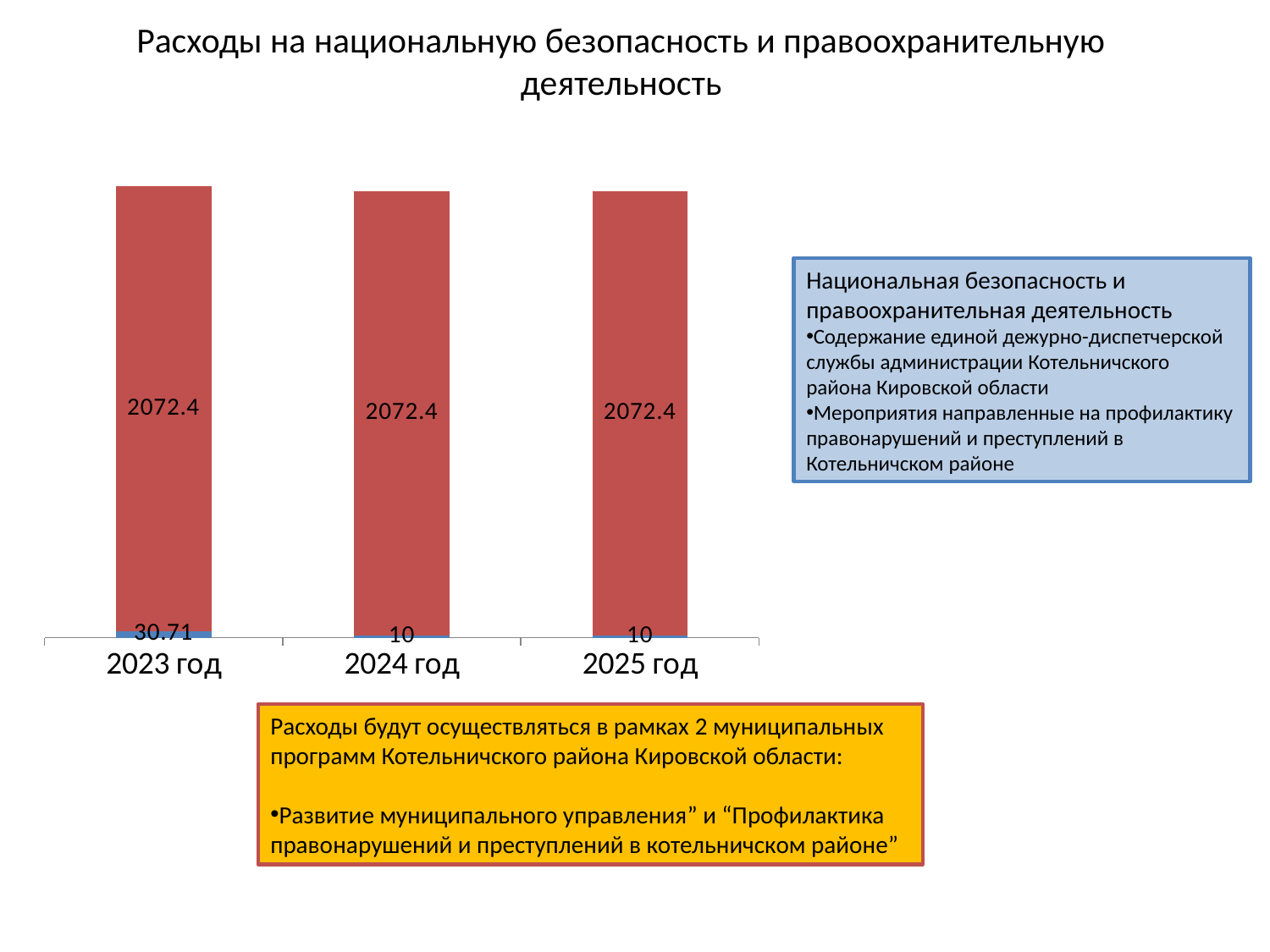
What kind of chart is shown on the slide? bar chart What is the value of the blue segment for 2023 год? 30.71 Which year has the highest value for the blue segment? 2023 год What is the title of the chart on the slide? Расходы на национальную безопасность и правоохранительную деятельность How many categories (years) are shown on the x axis of the chart? 3 What is the value of the red segment for 2023 год? 2072.4 What is the total of the stacked bar for 2024 год? 2082.4 What is the value of the red segment for 2025 год? 2072.4 What is the difference between the blue segment values for 2023 год and 2024 год? 20.71 Is the blue segment value for 2023 год larger or smaller than the blue segment value for 2025 год? larger What is the value of the blue segment for 2024 год? 10 What is the total of the stacked bar for 2023 год? 2103.11